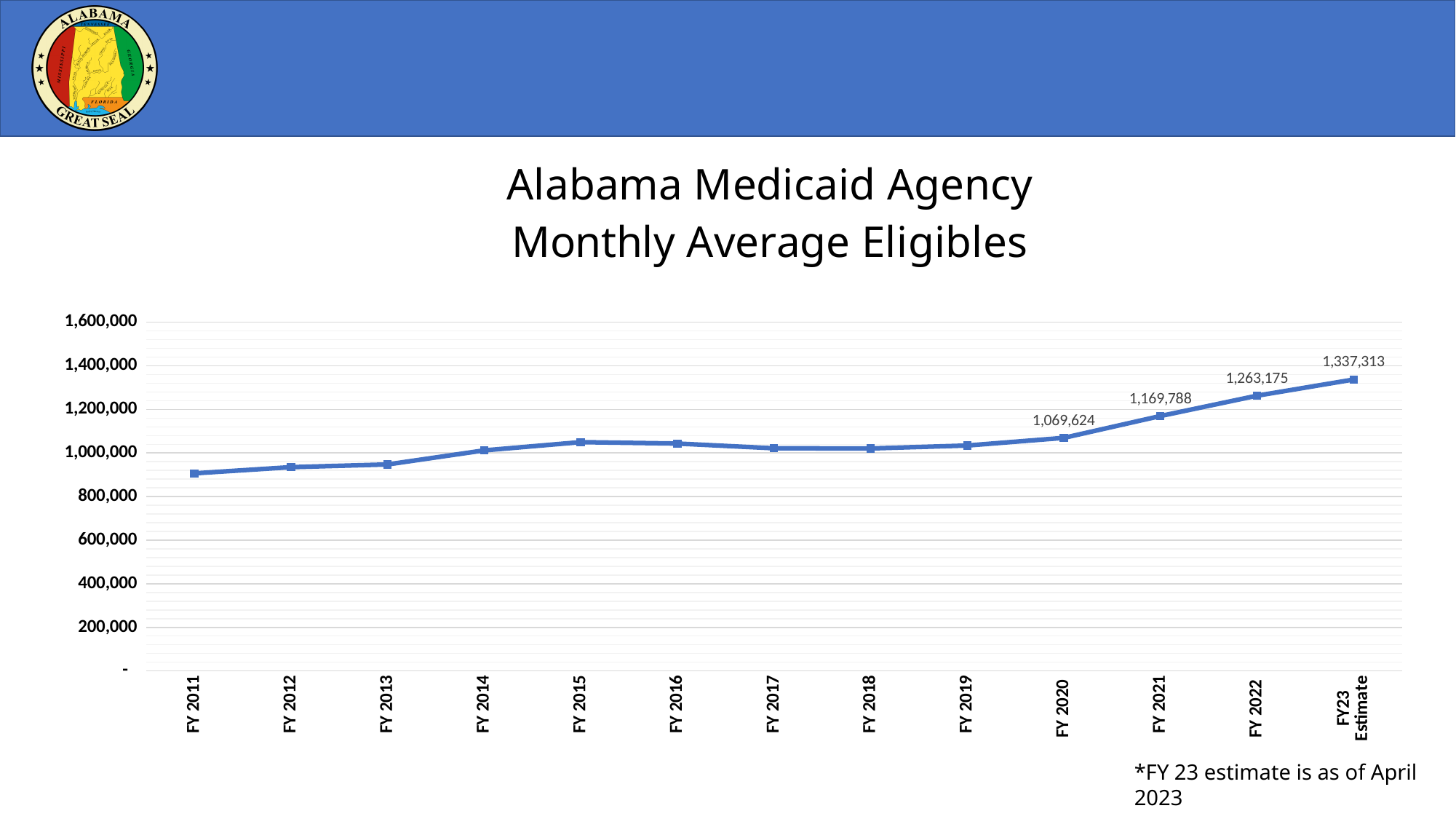
Which fiscal year has the highest value? FY23 Estimate Is the value for FY 2011 greater or less than 1,000,000? less How many fiscal years are plotted on the x axis? 13 What kind of chart is shown on the slide? line chart What is the value for FY 2022? 1,263,175 Which fiscal year has the lowest value? FY 2011 What is the value for FY23 Estimate? 1,337,313 What is the value for FY 2020? 1,069,624 What is the difference between the values for FY23 Estimate and FY 2022? 74,138 What is the difference between the values for FY 2022 and FY 2021? 93,387 Is the value for FY 2015 greater or less than 1,000,000? greater What is the value for FY 2021? 1,169,788